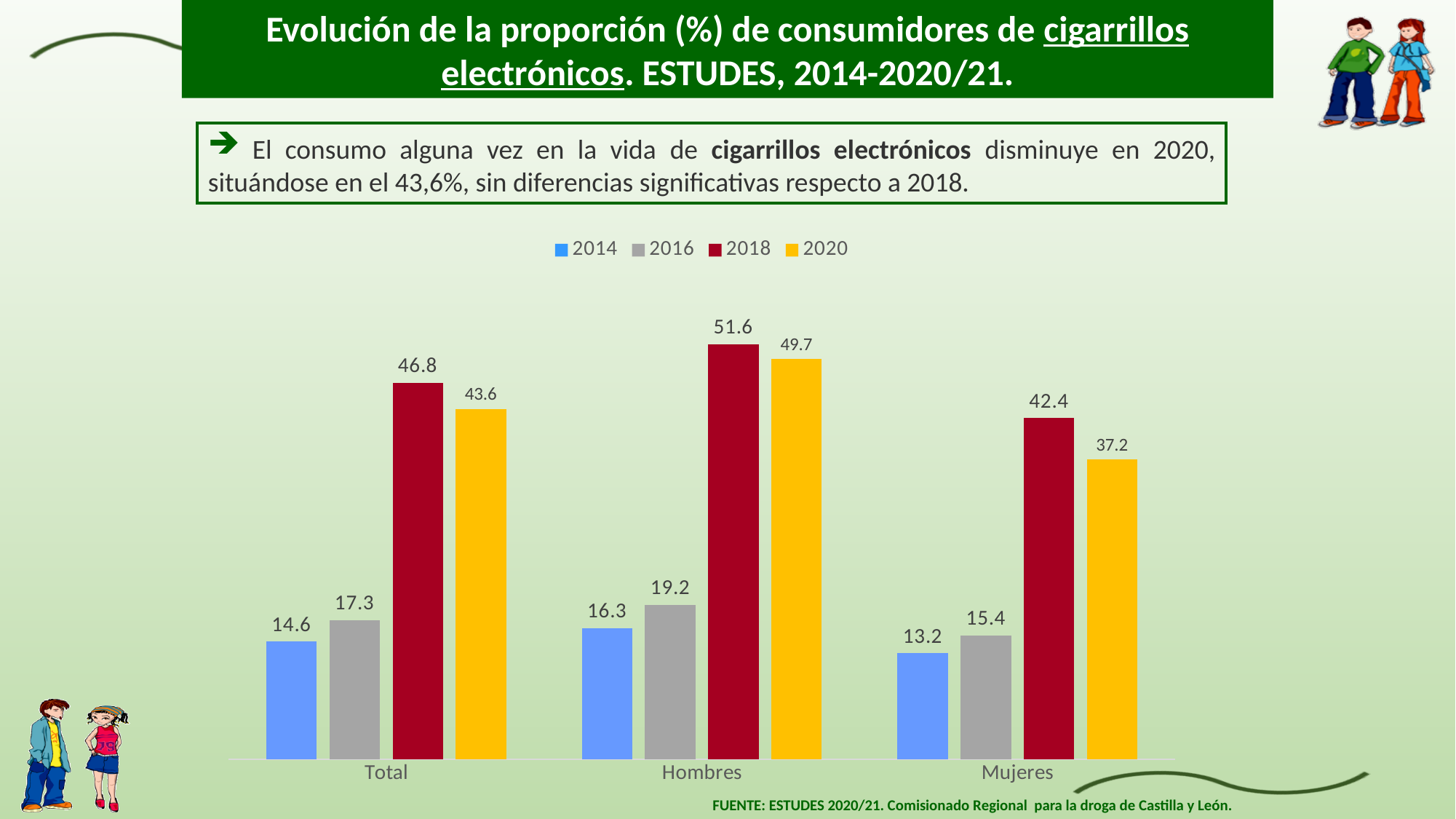
What kind of chart is shown on the slide? Bar chart What is the value for Mujeres in 2020? 37.2 How many series does the legend list? 4 Which category has the lowest value in 2014? Mujeres What is the value for Total in 2014? 14.6 What is the difference between the 2018 and 2020 values for Total? 3.2 How many categories are shown on the x axis? 3 Which is larger: the 2016 value for Hombres or the 2016 value for Mujeres? Hombres For Mujeres, do the values rise or fall from 2018 to 2020? Fall Which colour represents the 2018 series in the legend? Dark red Which category has the highest value in 2020? Hombres What is the value for Hombres in 2018? 51.6